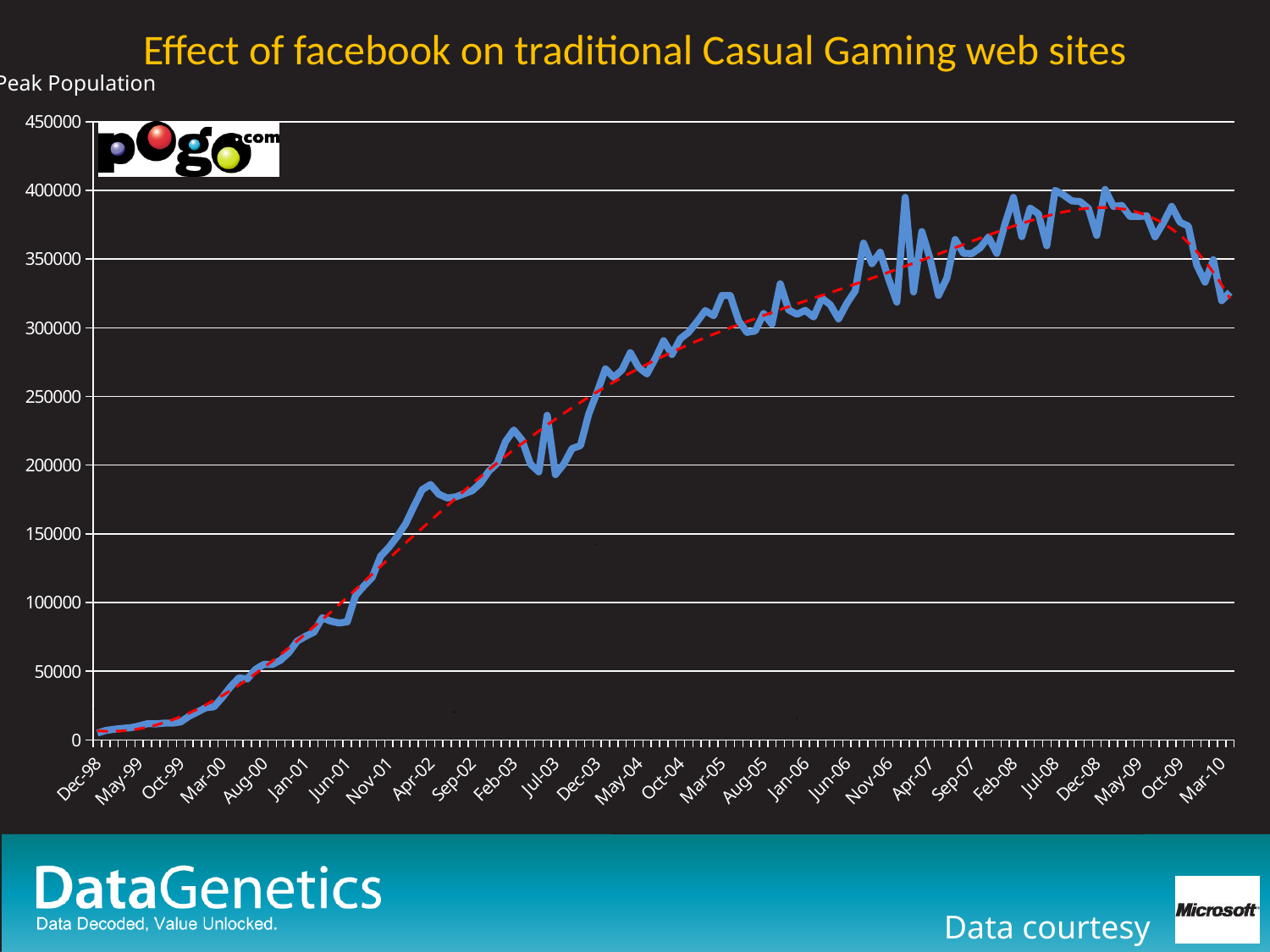
Is the value for Jun-01 greater or less than 100000? less What quantity does the y axis of the chart measure? Peak Population Is the value for Jul-08 greater or less than 350000? greater How does the peak population change from Dec-98 to Jul-08? It rises Which is larger, the value for Jun-01 or the value for Nov-01? Nov-01 What is the title of the slide containing the chart? Effect of facebook on traditional Casual Gaming web sites Is the value for Mar-10 greater or less than 300000? greater Which date has the lowest peak population on the chart? Dec-98 What kind of chart is shown on the slide? line chart